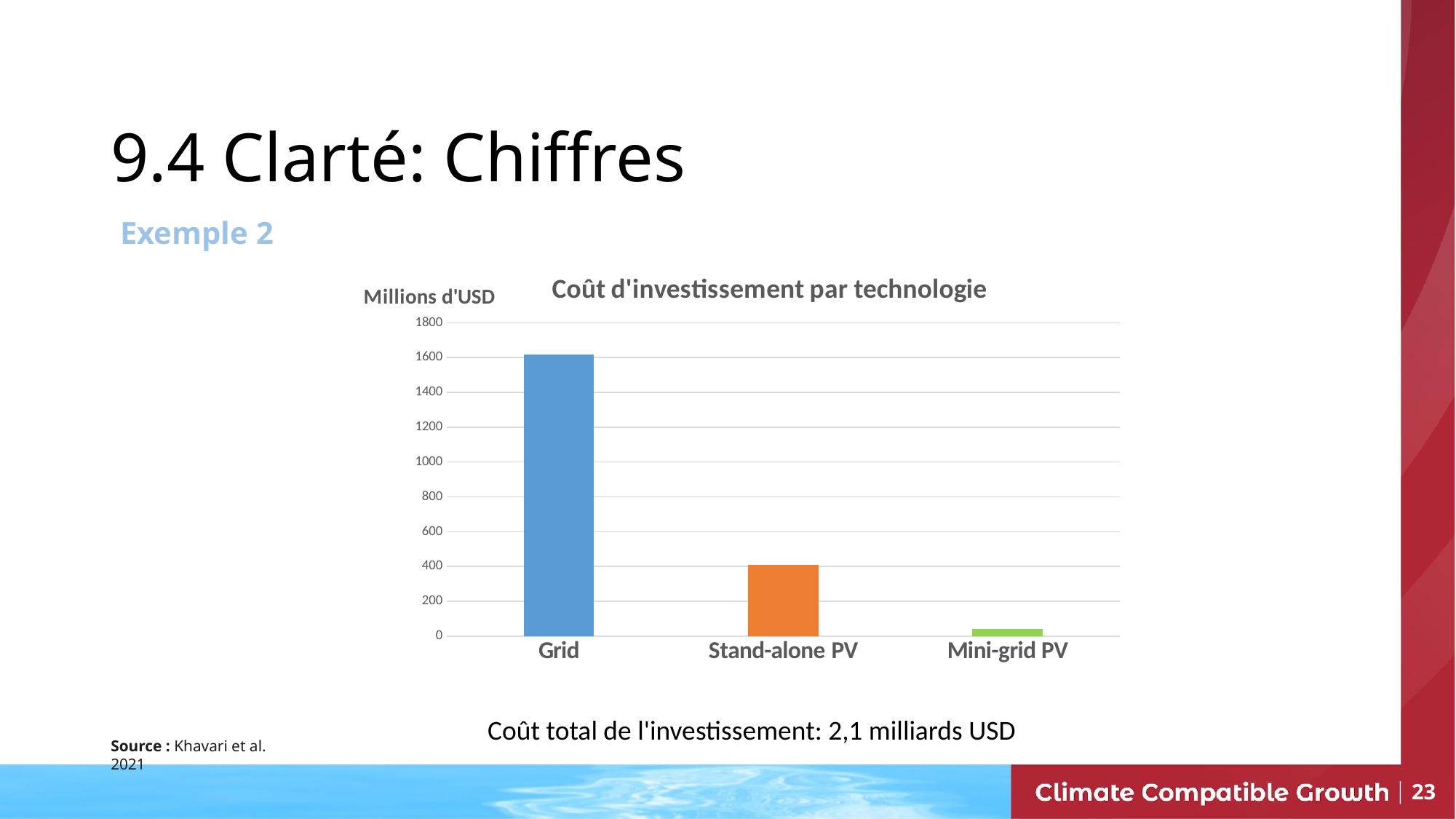
What kind of chart is shown on the slide? bar chart Which has a higher investment cost, Stand-alone PV or Mini-grid PV? Stand-alone PV Do the bar values rise or fall from left to right across the categories? fall What is the title of the chart? Coût d'investissement par technologie Is the value for Stand-alone PV greater or less than 200? greater Which has a higher investment cost, Grid or Stand-alone PV? Grid Is the value for Grid greater or less than 1400? greater How many technology categories are plotted in the chart? 3 Which technology has the lowest investment cost in the chart? Mini-grid PV Which technology has the highest investment cost in the chart? Grid Is the value for Stand-alone PV greater or less than 600? less